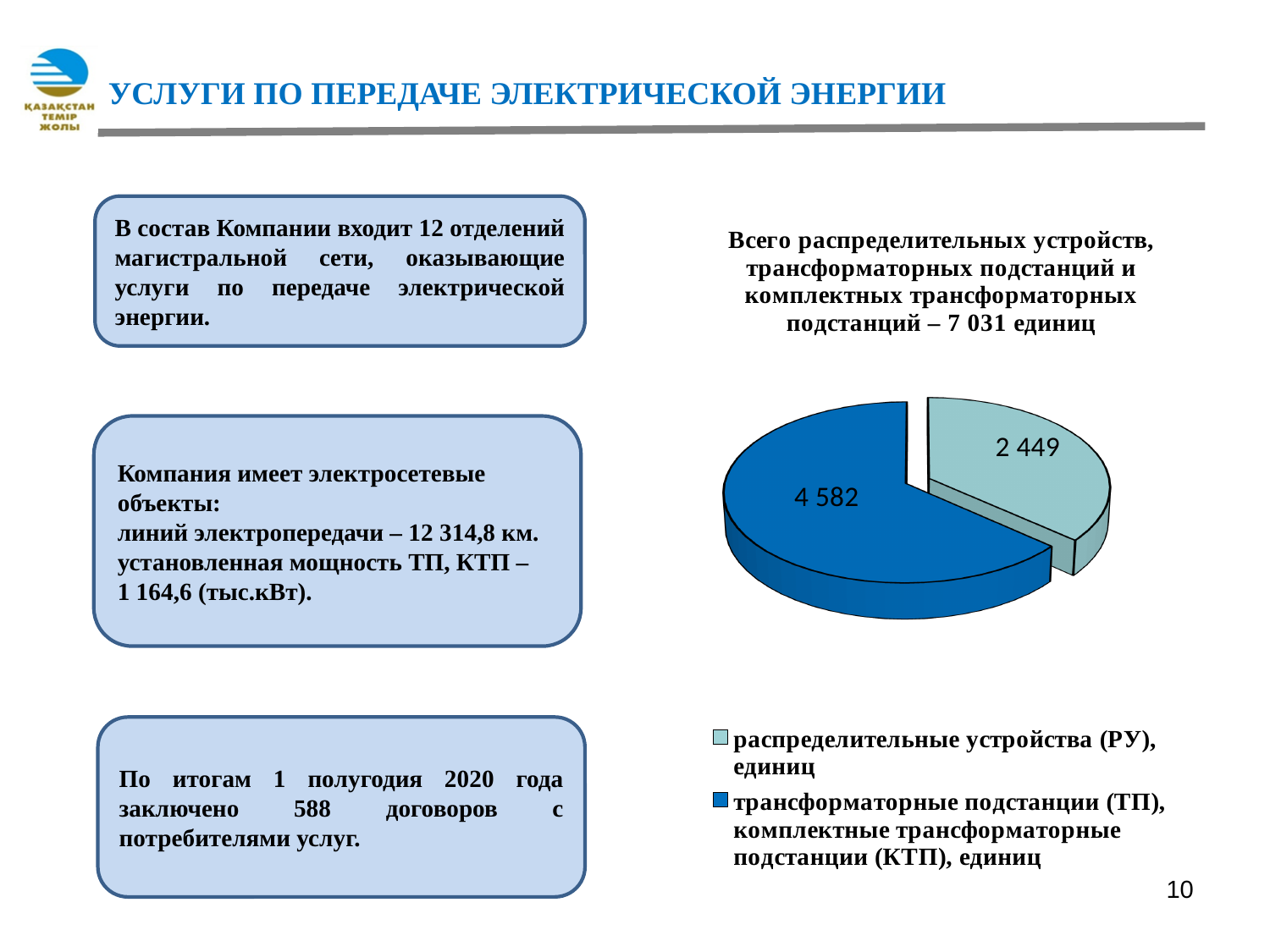
How many entries does the legend of the pie chart list? 2 What is the value for трансформаторные подстанции (ТП), комплектные трансформаторные подстанции (КТП) in the pie chart? 4 582 What is the value for распределительные устройства (РУ) in the pie chart? 2 449 What total number of units is stated in the title above the pie chart? 7 031 единиц What is the difference between the value for ТП/КТП and the value for РУ in the pie chart? 2 133 Which category has the smallest slice in the pie chart? распределительные устройства (РУ) What kind of chart is shown on the slide? pie chart Which is larger in the pie chart: the value for РУ or the value for ТП/КТП? ТП/КТП What colour is the slice for распределительные устройства (РУ) in the pie chart? light blue What is the total of the two slices in the pie chart? 7 031 How many slices does the pie chart have? 2 Which category has the largest slice in the pie chart? трансформаторные подстанции (ТП), комплектные трансформаторные подстанции (КТП)